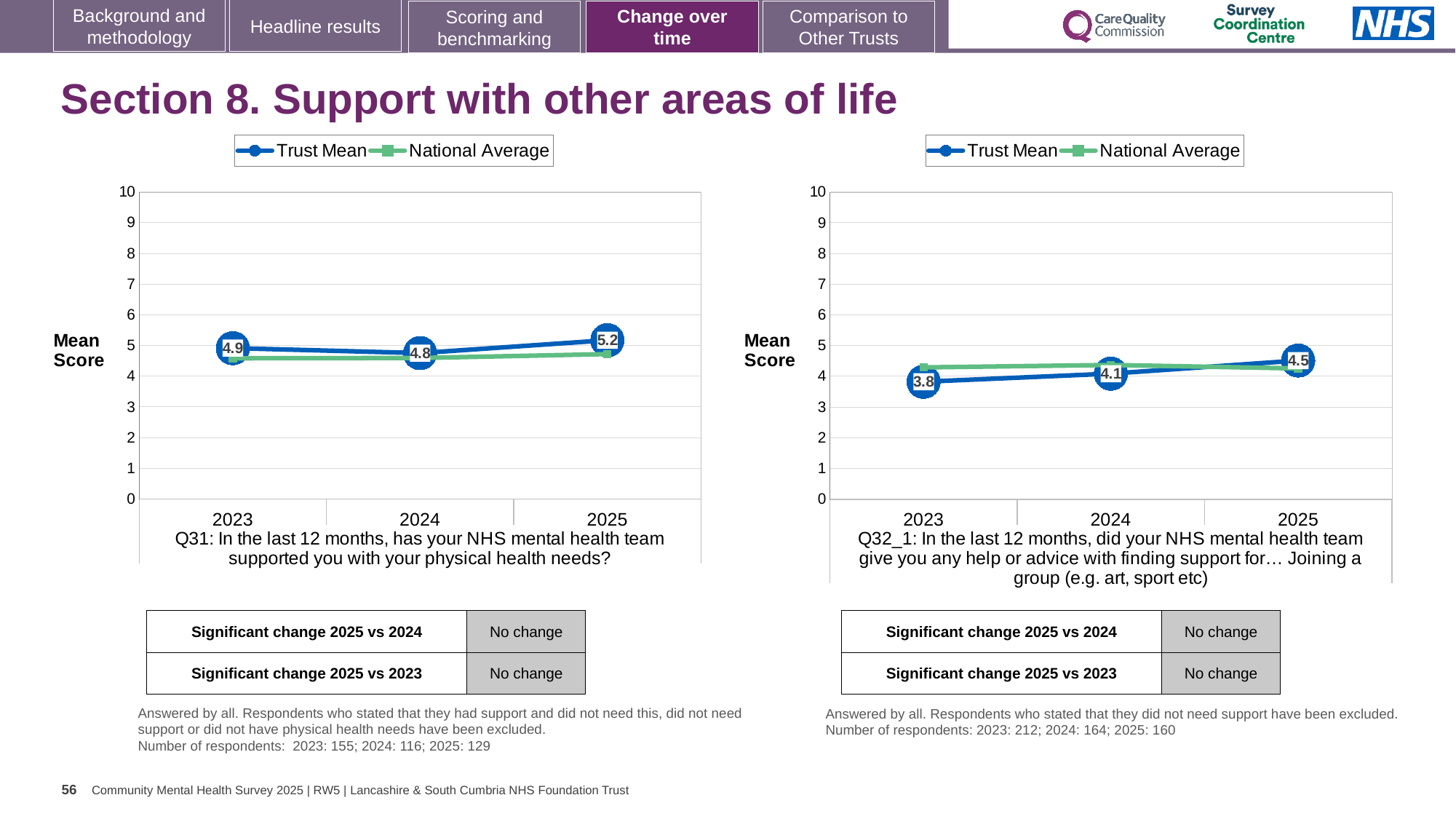
On the right chart (Q32_1), which year has the lowest Trust Mean? 2023 On the right chart (Q32_1), what is the difference between the Trust Mean for 2025 and 2023? 0.7 On the right chart (Q32_1), what is the Trust Mean for 2023? 3.8 On the right chart (Q32_1), what is the Trust Mean for 2024? 4.1 On the left chart (Q31), is the National Average for 2025 greater or less than 6? less What kind of chart is the left chart (Q31)? line chart How many series does the legend of the right chart (Q32_1) list? 2 On the right chart (Q32_1), does the Trust Mean rise or fall from 2023 to 2025? rise On the left chart (Q31), what is the Trust Mean for 2025? 5.2 On the left chart (Q31), what is the difference between the Trust Mean for 2025 and 2024? 0.4 On the left chart (Q31), which year has the highest Trust Mean? 2025 On the left chart (Q31), what is the Trust Mean for 2023? 4.9